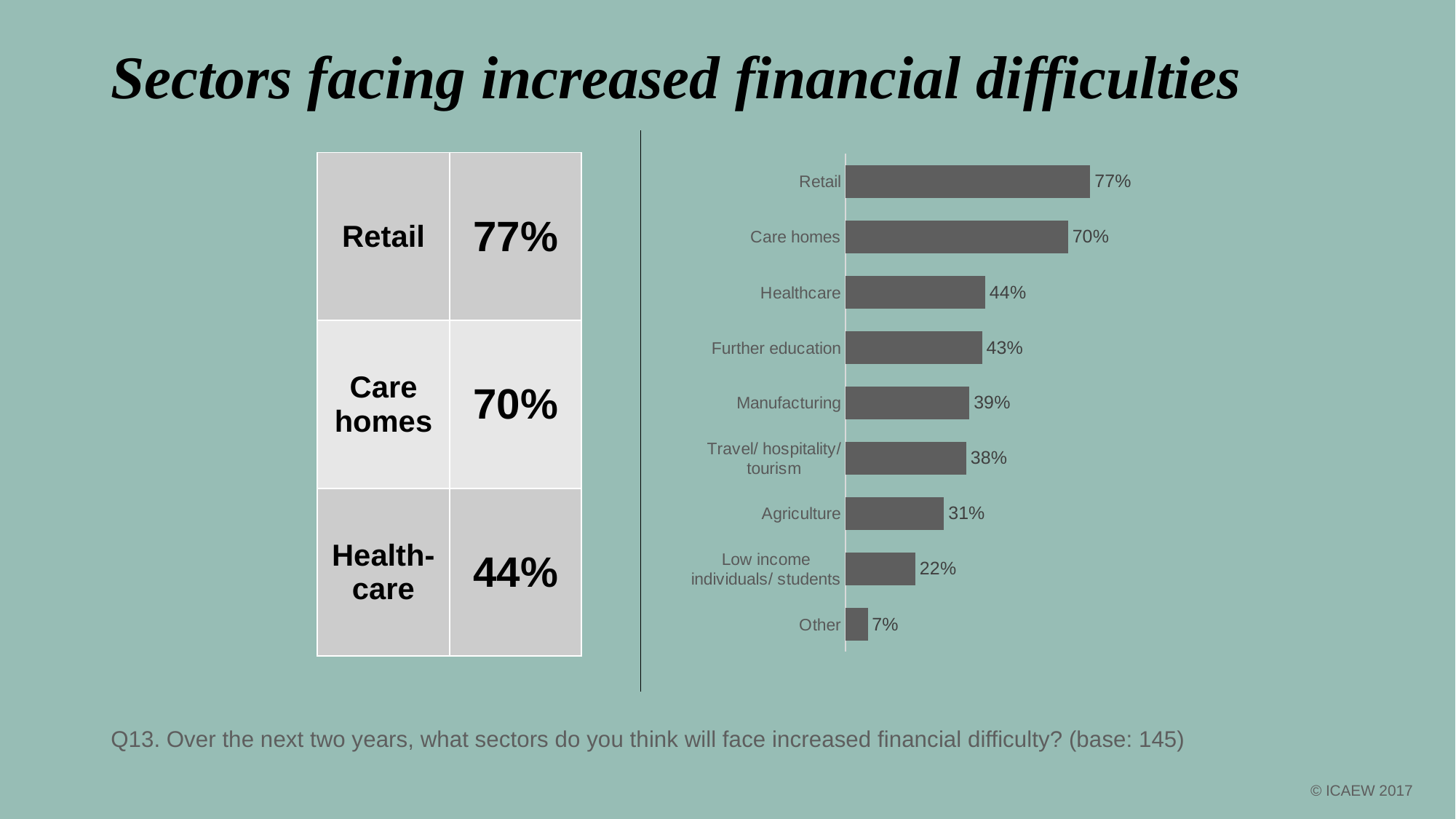
What is the value for Retail in the bar chart? 77% What is the difference between the values for Retail and Care homes? 7% Which category has the lowest value in the bar chart? Other What is the difference between the values for Healthcare and Agriculture? 13% What is the value for Travel/ hospitality/ tourism in the bar chart? 38% Which has a larger value, Further education or Agriculture? Further education What type of chart is shown on the slide? Bar chart What is the title of the slide? Sectors facing increased financial difficulties How many categories are shown in the bar chart? 9 What is the value for Low income individuals/ students in the bar chart? 22% Which sector has the highest value in the bar chart? Retail What is the value for Manufacturing in the bar chart? 39%